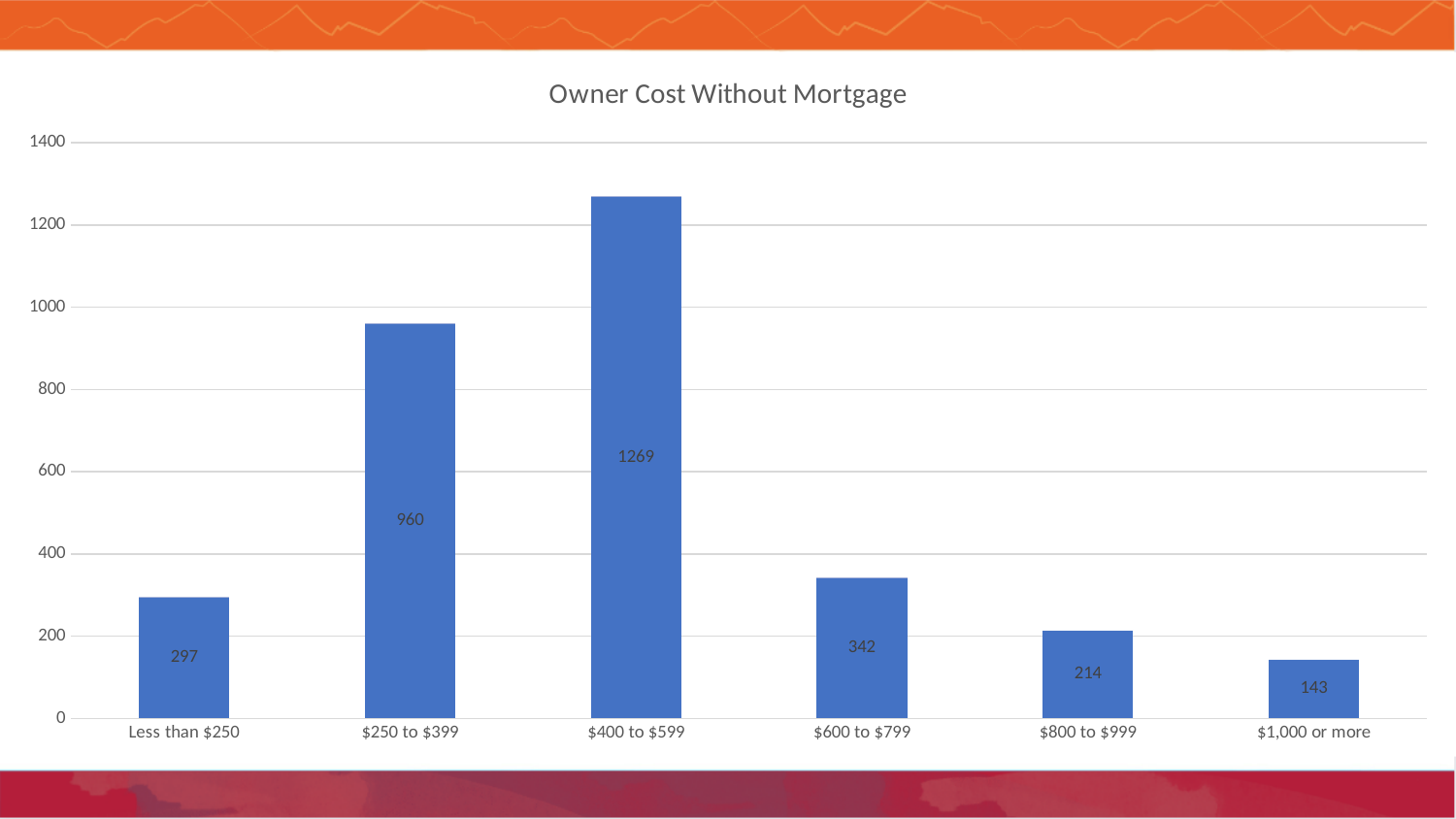
Which category has the lowest value? $1,000 or more What is the value for the $800 to $999 category? 214 What is the difference between the values for $400 to $599 and $250 to $399? 309 What kind of chart is shown on the slide? Bar chart What is the value for the $400 to $599 category? 1269 How many categories are shown on the x axis? 6 What is the difference between the values for $600 to $799 and $1,000 or more? 199 Which category has the highest value? $400 to $599 What is the value for the Less than $250 category? 297 Is the value for $250 to $399 greater or less than 1000? less What is the title of the chart? Owner Cost Without Mortgage Which is larger, the value for $600 to $799 or the value for Less than $250? $600 to $799